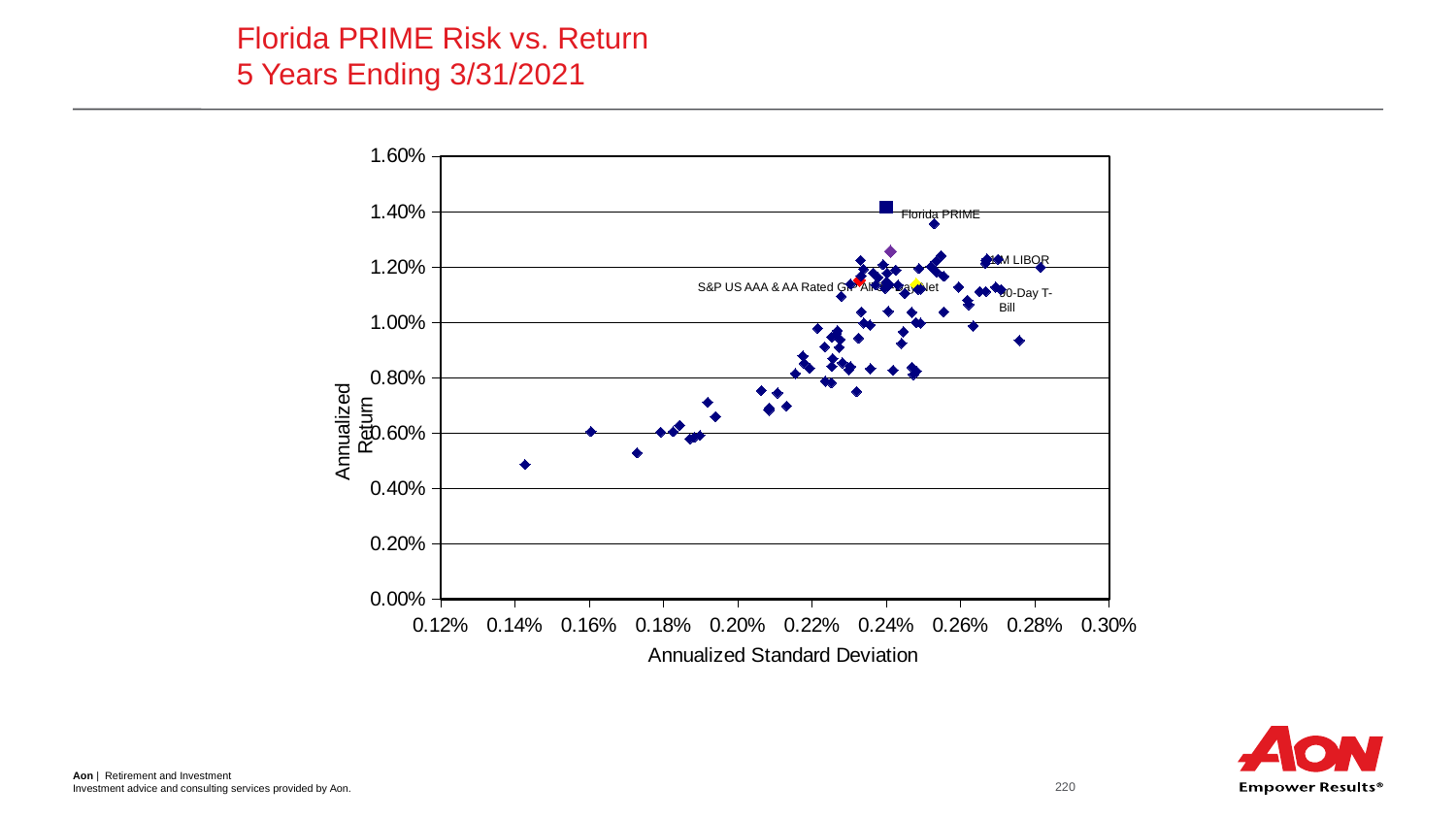
Is the annualized return for 30-Day T-Bill greater or less than 1.20%? less Is the annualized standard deviation for Florida PRIME greater or less than 0.26%? less Which has the higher annualized return, Florida PRIME or 1M LIBOR? Florida PRIME Is the annualized standard deviation for 1M LIBOR greater or less than 0.26%? greater Which has the higher annualized return, 1M LIBOR or 30-Day T-Bill? 1M LIBOR Which labeled point has the highest annualized return on the chart? Florida PRIME What is the label of the horizontal axis of the chart? Annualized Standard Deviation What is the title of the chart on the slide? Florida PRIME Risk vs. Return 5 Years Ending 3/31/2021 What kind of chart is shown on the slide? Scatter chart Do annualized returns generally rise or fall as annualized standard deviation increases along the x axis? rise